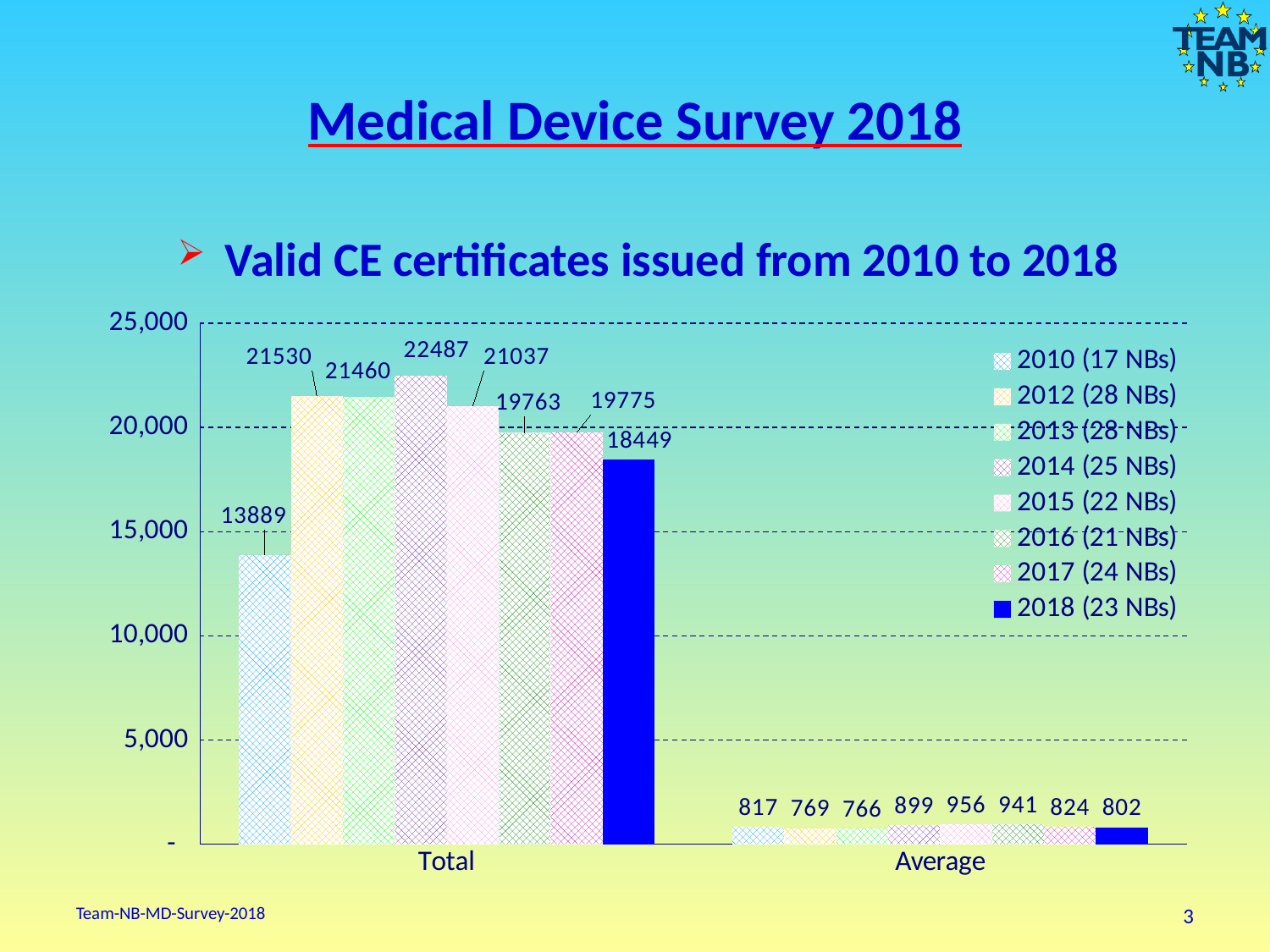
How many categories are shown on the x axis? 2 What is the Total value for 2014 (25 NBs)? 22487 Which series has the lowest Total value? 2010 (17 NBs) Is the Total value for 2010 (17 NBs) greater or less than 15,000? less Which series has the lowest Average value? 2013 (28 NBs) What is the Average value for 2015 (22 NBs)? 956 How many series does the legend list? 8 What is the Total value for 2018 (23 NBs)? 18449 What kind of chart is shown on the slide? bar chart Which is larger, the Total value for 2012 (28 NBs) or for 2013 (28 NBs)? 2012 (28 NBs) What is the difference between the Total values for 2014 (25 NBs) and 2010 (17 NBs)? 8598 Which series has the highest Total value? 2014 (25 NBs)